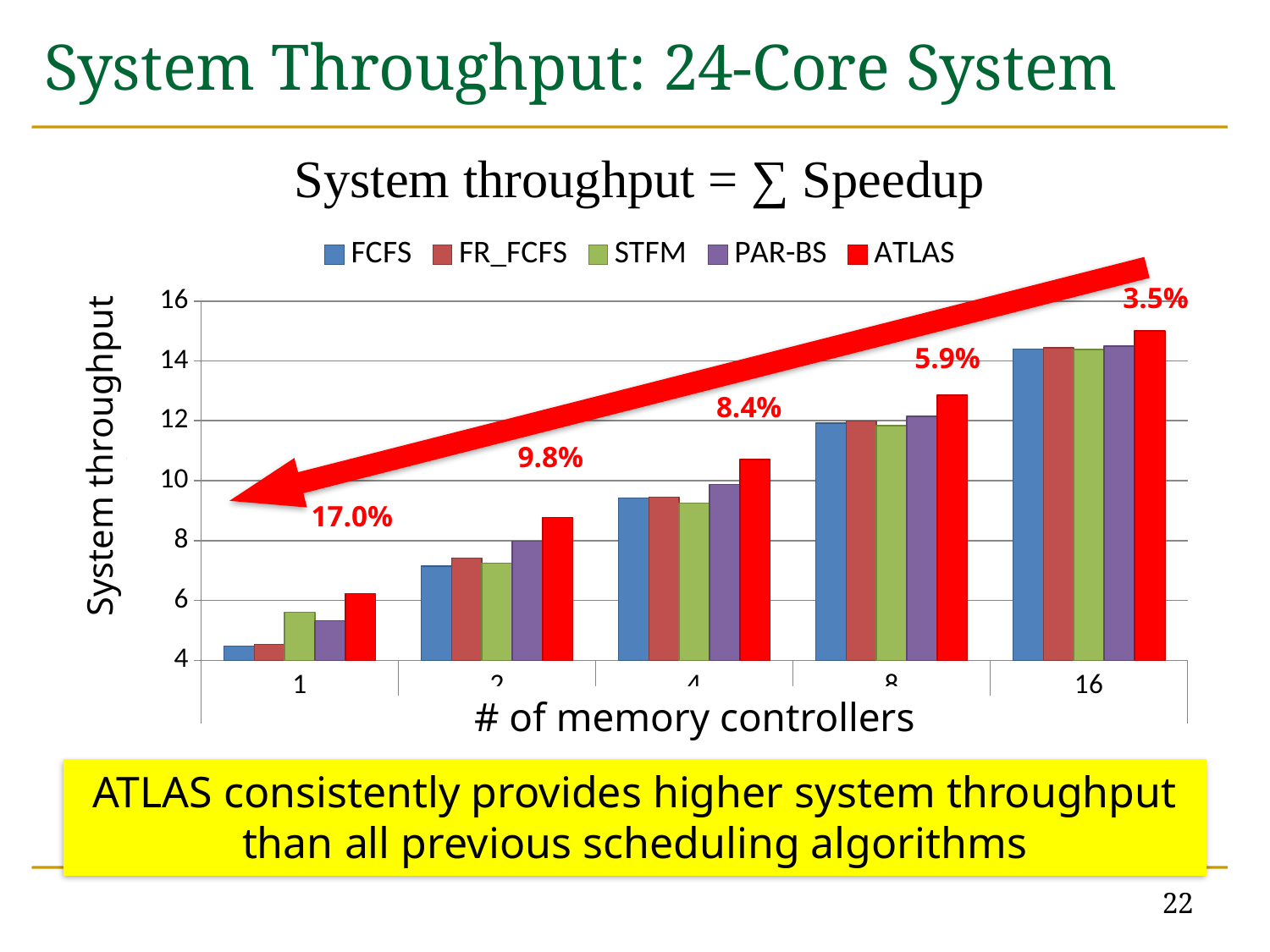
What percentage is printed above the bars for 1 memory controller? 17.0% Does system throughput rise or fall as the number of memory controllers increases? rise Which number of memory controllers gives the lowest system throughput for all series? 1 How many series does the legend list? 5 What is the label of the x axis? # of memory controllers What kind of chart is shown on the slide? bar chart Is the FCFS value at 1 memory controller greater or less than 6? less Which series has the highest system throughput at 16 memory controllers? ATLAS Which series is drawn in red? ATLAS Is the ATLAS value at 16 memory controllers greater or less than 14? greater What percentage is printed above the bars for 16 memory controllers? 3.5% How many categories (numbers of memory controllers) are shown on the x axis? 5